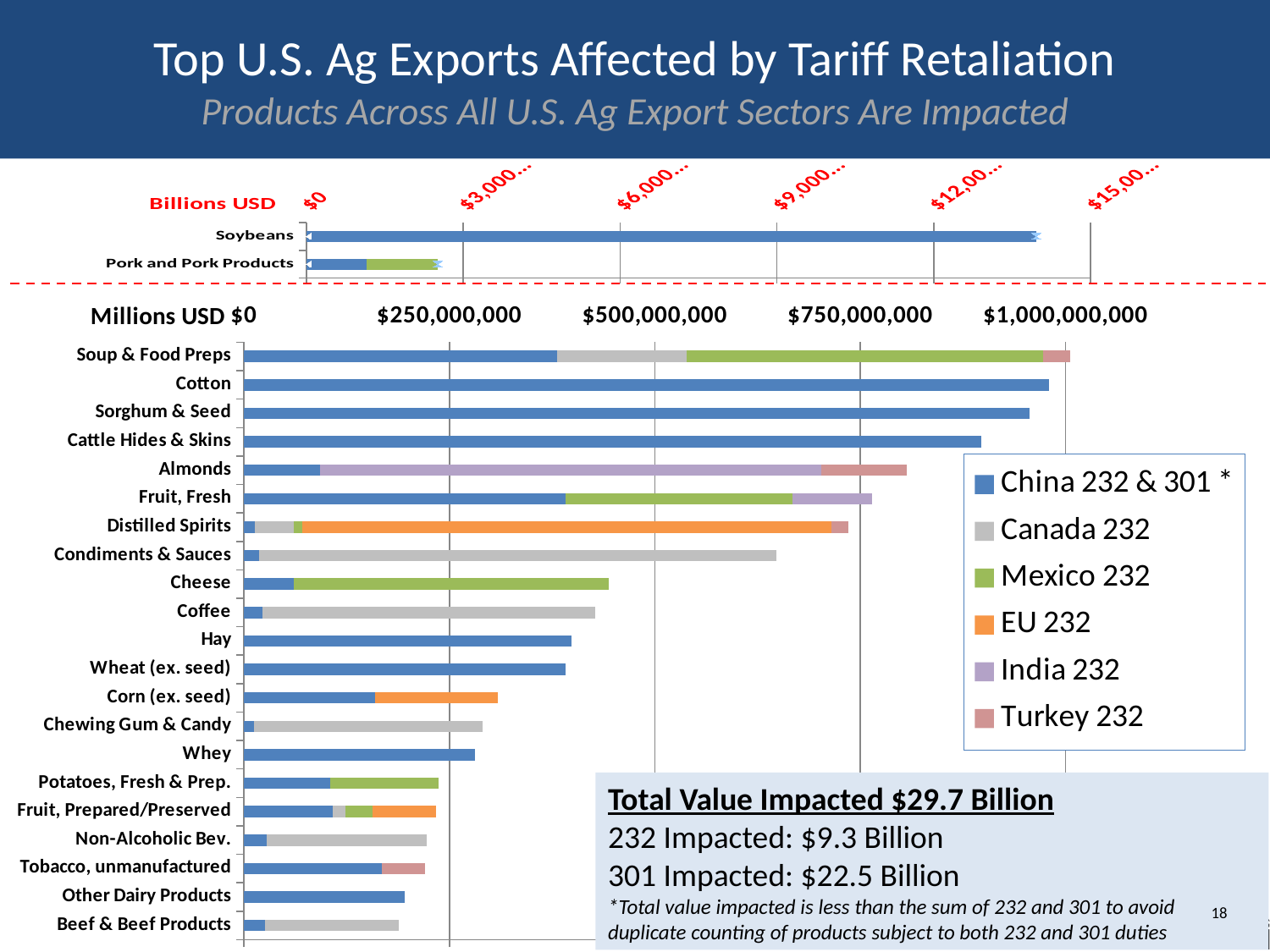
In the top chart (Billions USD), is the value for Soybeans greater or less than $12,000? greater How many product categories are plotted in the bottom chart (Millions USD)? 21 In the bottom chart (Millions USD), is the total bar for Condiments & Sauces longer than the total bar for Cheese? Yes What kind of chart is the bottom chart (Millions USD)? bar chart In the top chart (Billions USD), is the value for Pork and Pork Products greater or less than $3,000? less How many series does the legend of the bottom chart (Millions USD) list? 6 In the bottom chart (Millions USD), is the value for Hay greater or less than $500,000,000? less In the bottom chart (Millions USD), which colour represents the EU 232 series in the legend? orange In the bottom chart (Millions USD), which product has the longest total bar? Soup & Food Preps In the bottom chart (Millions USD), which is larger: the total for Cattle Hides & Skins or the total for Almonds? Cattle Hides & Skins In the top chart (Billions USD), which of the two products has the higher value? Soybeans